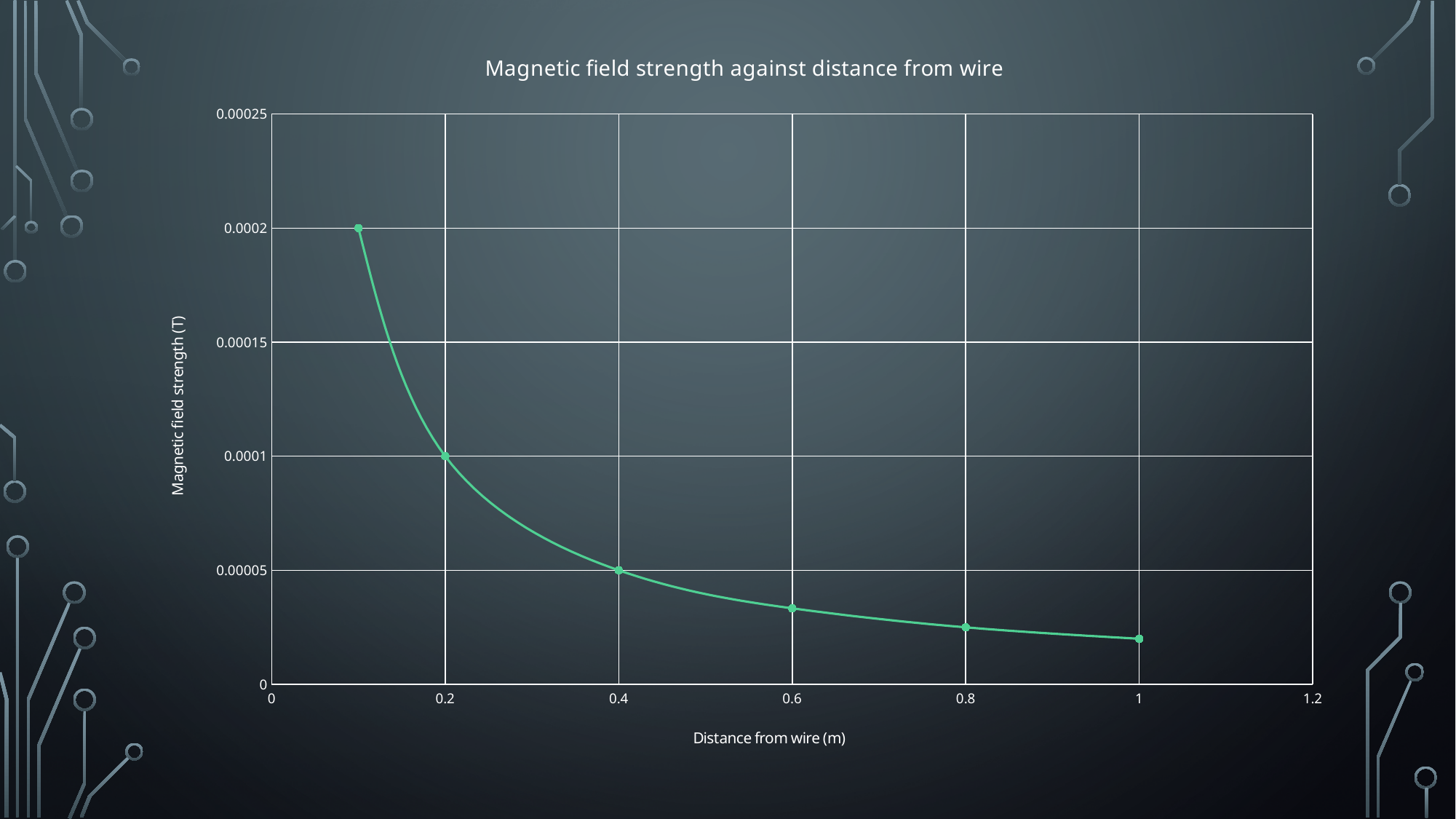
At which distance from the wire is the magnetic field strength lowest? 1 What is the magnetic field strength at a distance of 0.2 m from the wire? 0.0001 Does the magnetic field strength rise or fall as distance from the wire increases? fall What is the title of the chart? Magnetic field strength against distance from wire What is the magnetic field strength at the leftmost plotted point? 0.0002 What is the magnetic field strength at a distance of 0.4 m from the wire? 0.00005 What is the difference in magnetic field strength between 0.2 m and 0.4 m from the wire? 0.00005 What kind of chart is shown on the slide? line chart How many data points are plotted on the chart? 6 Is the magnetic field strength at 0.6 m greater or less than 0.00005? less Is the magnetic field strength at 1 m greater or less than 0.00005? less Which has a larger magnetic field strength: 0.2 m or 0.4 m from the wire? 0.2